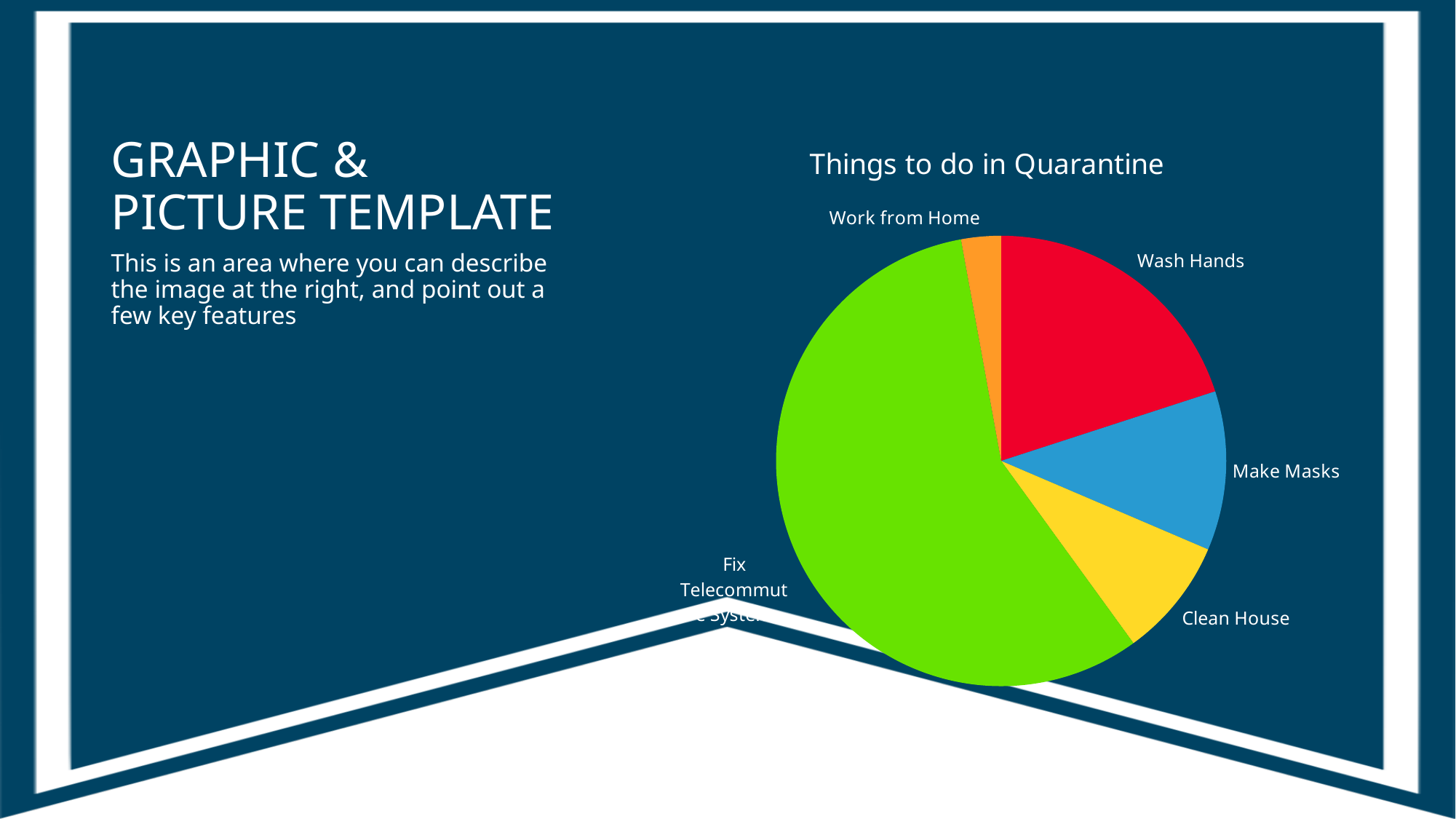
Which category has the smallest slice of the pie? Work from Home What colour is the Wash Hands slice? Red Is the Fix Telecommute System slice greater or less than half of the pie? greater What is the title of the chart? Things to do in Quarantine What kind of chart is shown on the slide? Pie chart Which slice is larger, Wash Hands or Clean House? Wash Hands Which category has the largest slice of the pie? Fix Telecommute System Which slice is larger, Work from Home or Make Masks? Make Masks Which slice is larger, Wash Hands or Make Masks? Wash Hands How many slices does the pie chart have? 5